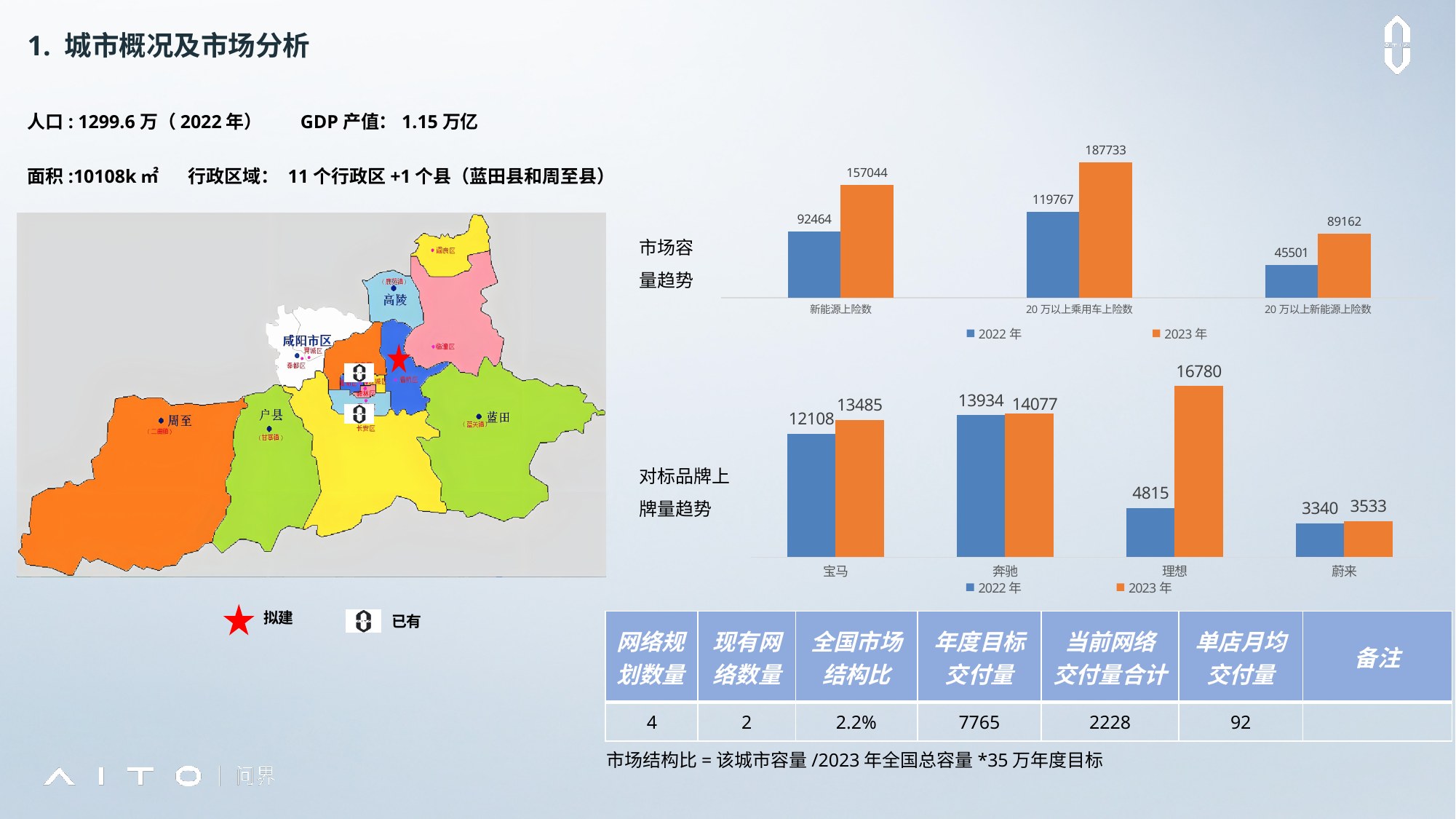
In the 对标品牌上牌量趋势 chart, what is the difference between the 2023年 and 2022年 values for 宝马? 1377 In the 市场容量趋势 chart, what is the difference between the 2023年 and 2022年 values for 20万以上乘用车上险数? 67966 In the 市场容量趋势 chart, how many series does the legend list? 2 In the 市场容量趋势 chart, which category has the highest 2023年 value? 20万以上乘用车上险数 In the 市场容量趋势 chart, what is the 2023年 value for 新能源上险数? 157044 In the 对标品牌上牌量趋势 chart, which brand has the lowest 2023年 value? 蔚来 What kind of chart is the 市场容量趋势 chart? bar chart In the 对标品牌上牌量趋势 chart, how many brands are shown on the x axis? 4 In the 对标品牌上牌量趋势 chart, what is the 2023年 value for 理想? 16780 In the 对标品牌上牌量趋势 chart, what is the 2022年 value for 蔚来? 3340 In the 对标品牌上牌量趋势 chart, which brand has the highest 2022年 value? 奔驰 In the 市场容量趋势 chart, what is the 2022年 value for 20万以上新能源上险数? 45501